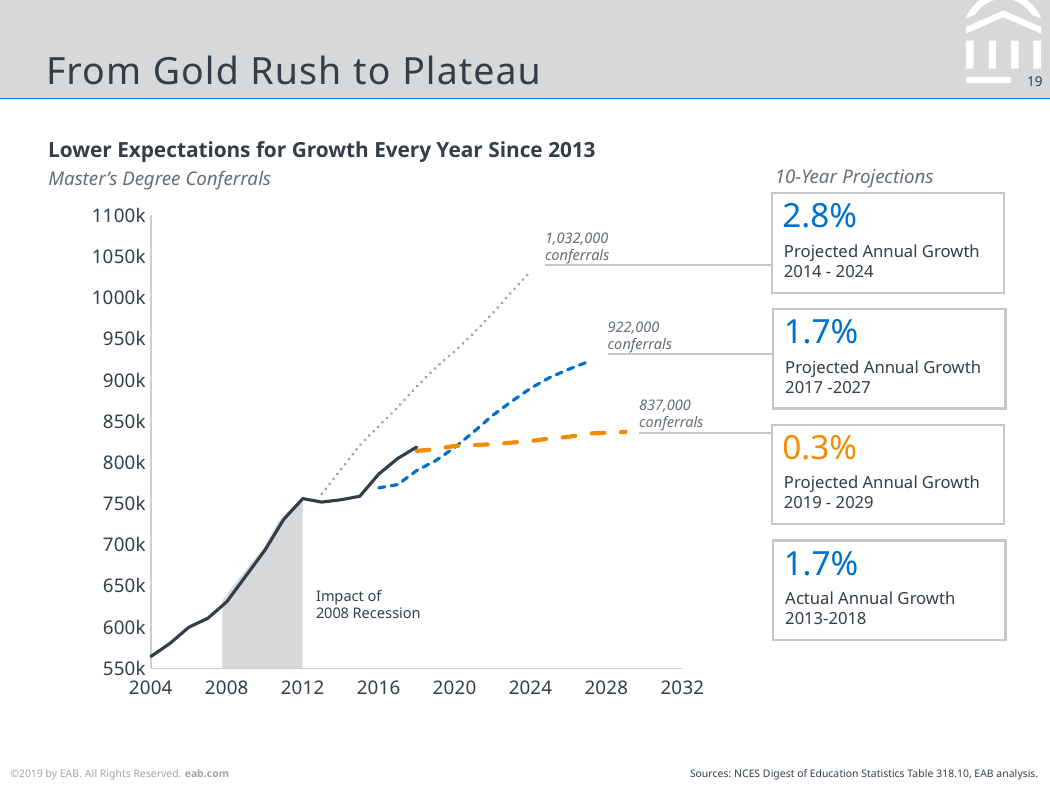
How many conferrals does the 2014-2024 projection line reach at its endpoint? 1,032,000 conferrals What is the projected annual growth for 2019 - 2029 shown on the slide? 0.3% Is the actual number of Master's degree conferrals in 2004 greater or less than 600k? less What kind of chart is shown on the slide? line chart Which projection ends at the highest number of conferrals? the 2014-2024 projection (1,032,000 conferrals) Do actual Master's degree conferrals rise or fall from 2004 to 2018? rise What does the shaded grey area on the chart represent? Impact of 2008 Recession Is the actual number of Master's degree conferrals in 2012 greater or less than 700k? greater How many conferrals does the 2019-2029 projection line reach at its endpoint? 837,000 conferrals What is the difference between the 1,032,000 conferrals endpoint and the 837,000 conferrals endpoint? 195,000 How many conferrals does the 2017-2027 projection line reach at its endpoint? 922,000 conferrals What is the difference between the 922,000 conferrals endpoint and the 837,000 conferrals endpoint? 85,000